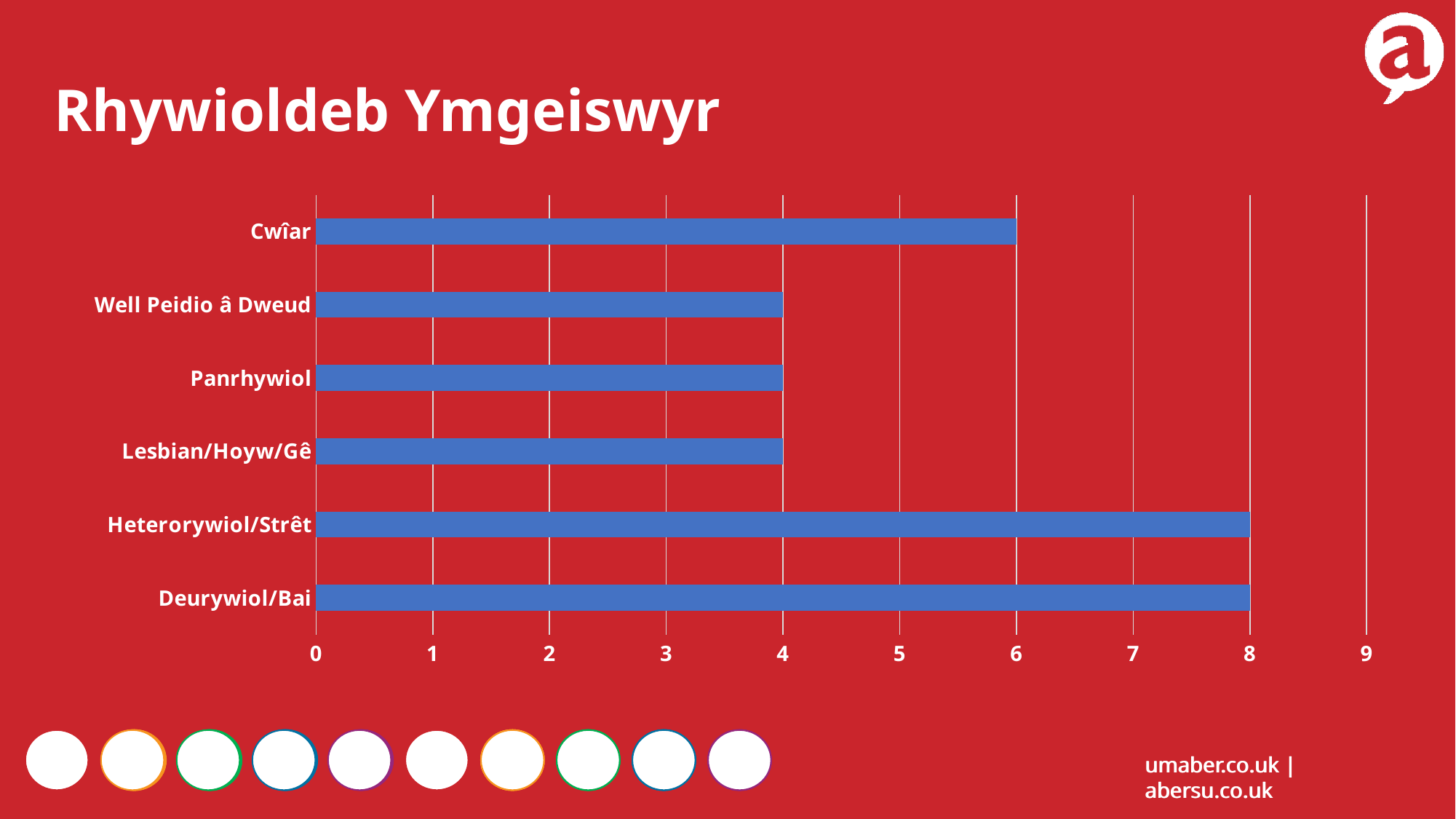
What is the value for Panrhywiol? 4 What is the value for Well Peidio â Dweud? 4 What is the difference between the values for Heterorywiol/Strêt and Cwîar? 2 Which is larger, the value for Deurywiol/Bai or the value for Well Peidio â Dweud? Deurywiol/Bai How many categories are shown in the chart? 6 What is the value for Heterorywiol/Strêt? 8 Which is larger, the value for Cwîar or the value for Panrhywiol? Cwîar What is the difference between the values for Cwîar and Lesbian/Hoyw/Gê? 2 Is the value for Cwîar greater or less than 5? greater What kind of chart is shown on the slide? bar chart What is the value for Cwîar? 6 What is the value for Deurywiol/Bai? 8